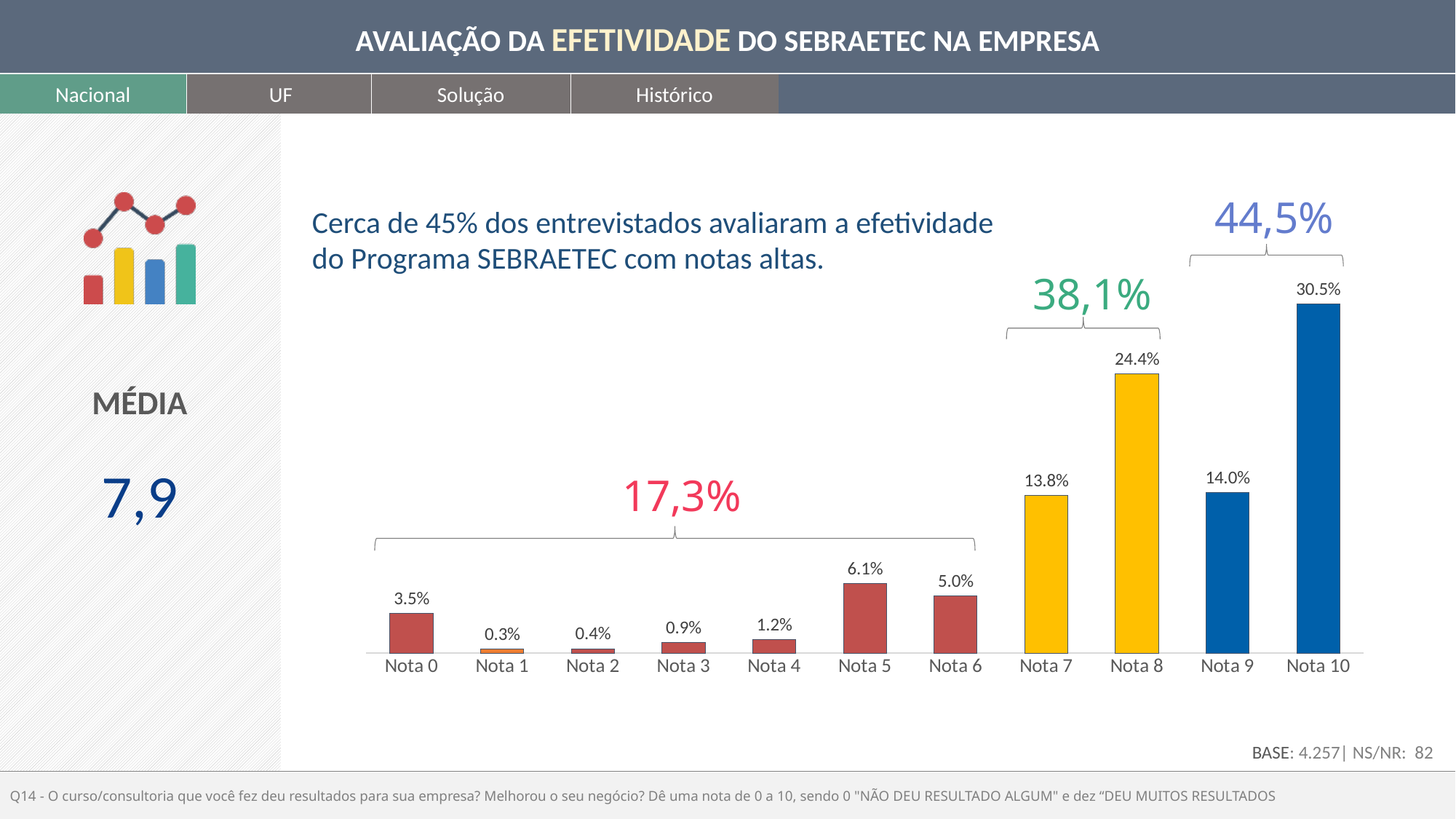
Which category has the lowest value? Nota 1 What is the difference between the values for Nota 10 and Nota 8? 6.1% What is the combined share shown for Nota 7 and Nota 8 (the green bracket label)? 38,1% What is the value for Nota 1? 0.3% Which category has the highest value? Nota 10 What is the value for Nota 10? 30.5% What is the value for Nota 8? 24.4% What is the difference between the values for Nota 9 and Nota 7? 0.2% What kind of chart is shown on the slide? Bar chart How many categories are shown on the x axis? 11 What is the combined share shown for Nota 9 and Nota 10 (the blue bracket label)? 44,5% Which is larger, the value for Nota 5 or the value for Nota 6? Nota 5